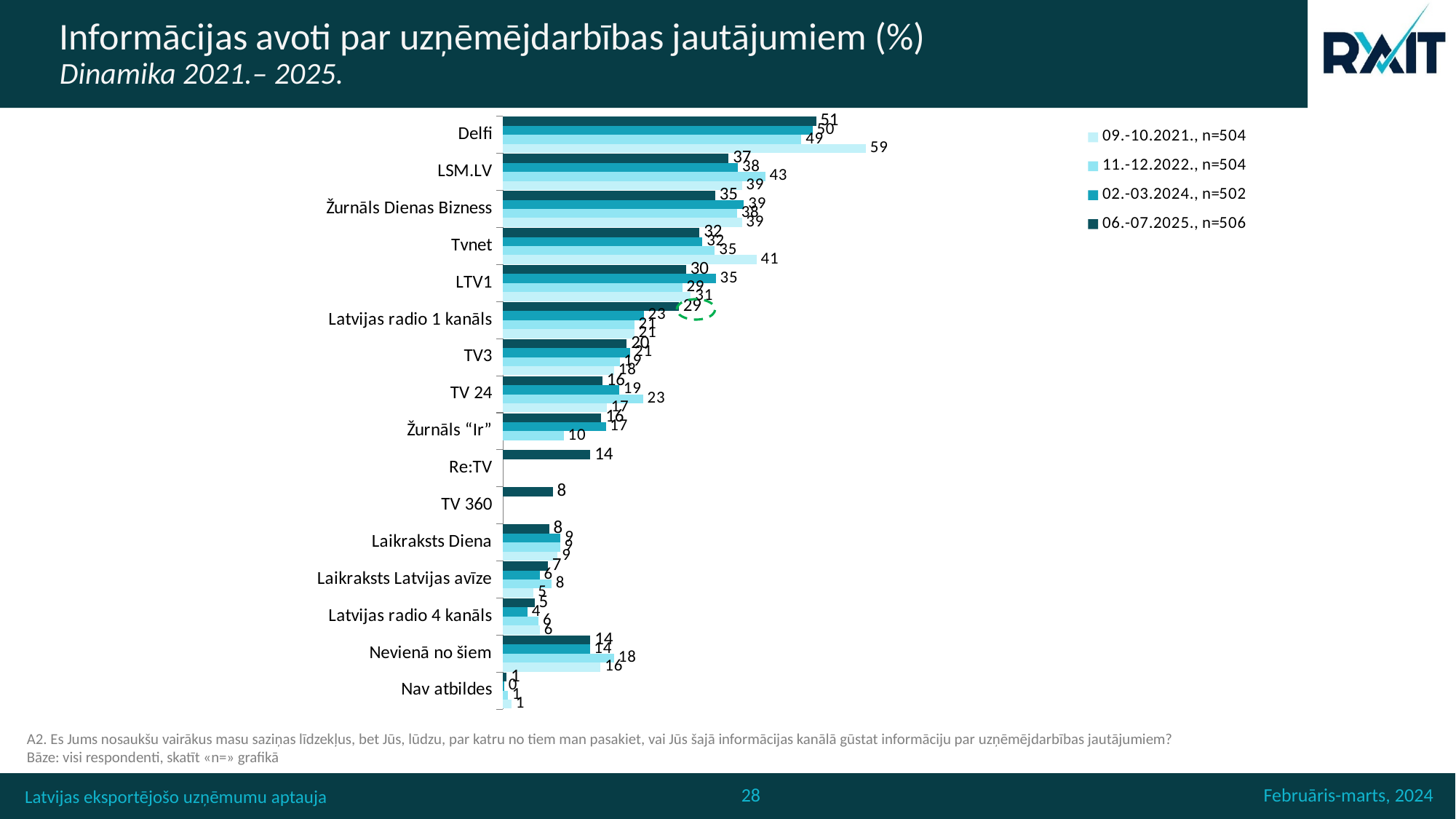
What sample size (n) does the legend give for the 06.-07.2025. series? n=506 How many series does the legend list? 4 What is the value for Nevienā no šiem in the 11.-12.2022. series? 18 What is the value for Re:TV in the 06.-07.2025. series? 14 How many categories are shown on the chart? 16 In the 11.-12.2022. series, which is larger: LSM.LV or Tvnet? LSM.LV What is the difference between the Delfi values for 09.-10.2021. and 06.-07.2025.? 8 What kind of chart is shown on the slide? Bar chart What is the value for TV 360 in the 06.-07.2025. series? 8 Which category has the highest value in the 06.-07.2025. series? Delfi What is the value for Latvijas radio 1 kanāls in the 06.-07.2025. series? 29 What is the value for Delfi in the 09.-10.2021. series? 59